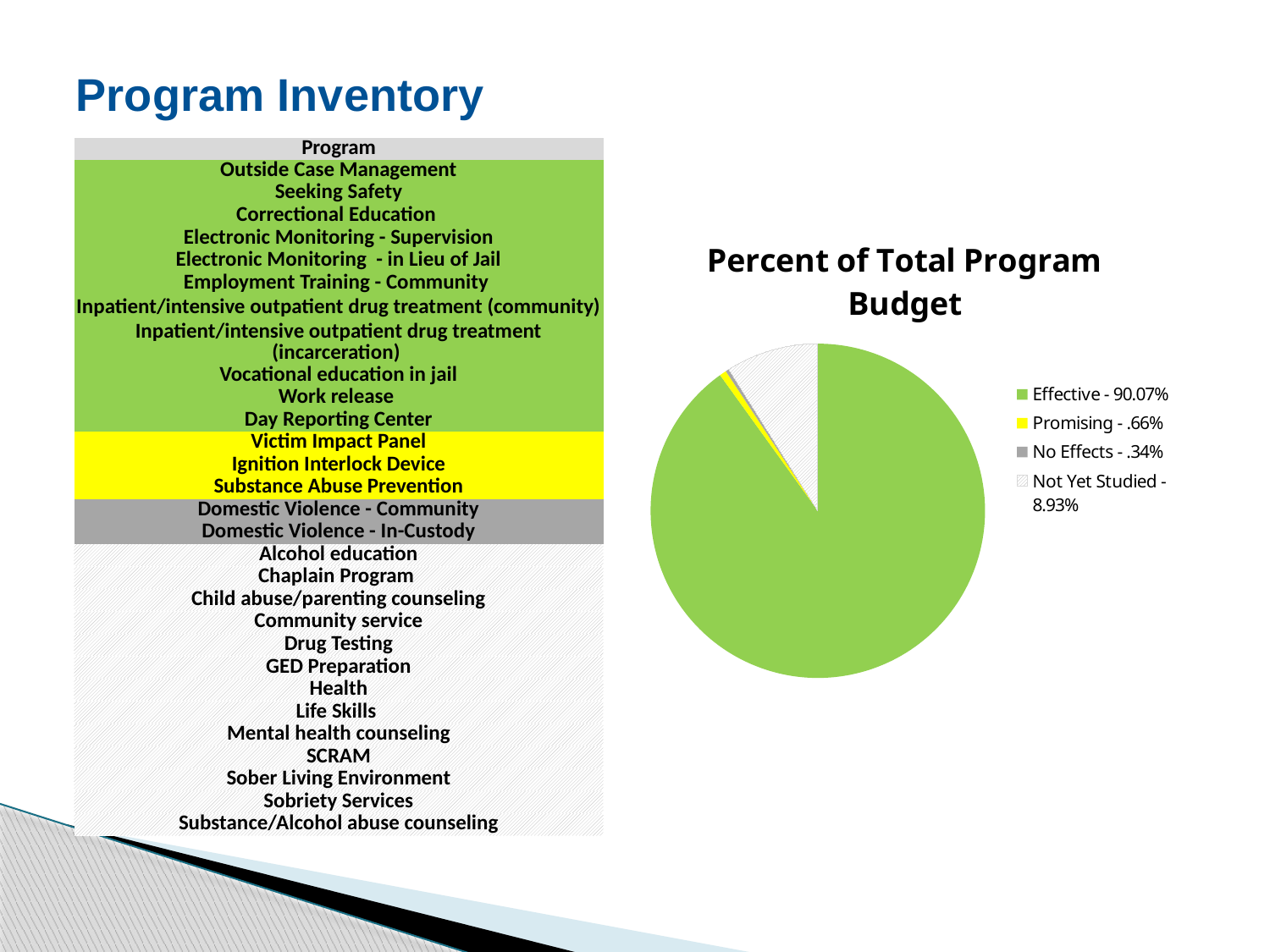
What colour is the Effective slice of the pie chart? green What is the difference in percentage points between the Effective share and the Not Yet Studied share? 81.14% Which category has the smallest share of the total program budget? No Effects How many categories does the pie chart show? 4 What percentage of the total program budget goes to Not Yet Studied programs? 8.93% What percentage of the total program budget goes to Promising programs? .66% What percentage of the total program budget goes to No Effects programs? .34% What is the title of the chart? Percent of Total Program Budget What kind of chart is shown on the slide? pie chart What percentage of the total program budget goes to Effective programs? 90.07% Which has a larger share of the budget, Promising or No Effects? Promising Which category has the largest share of the total program budget? Effective